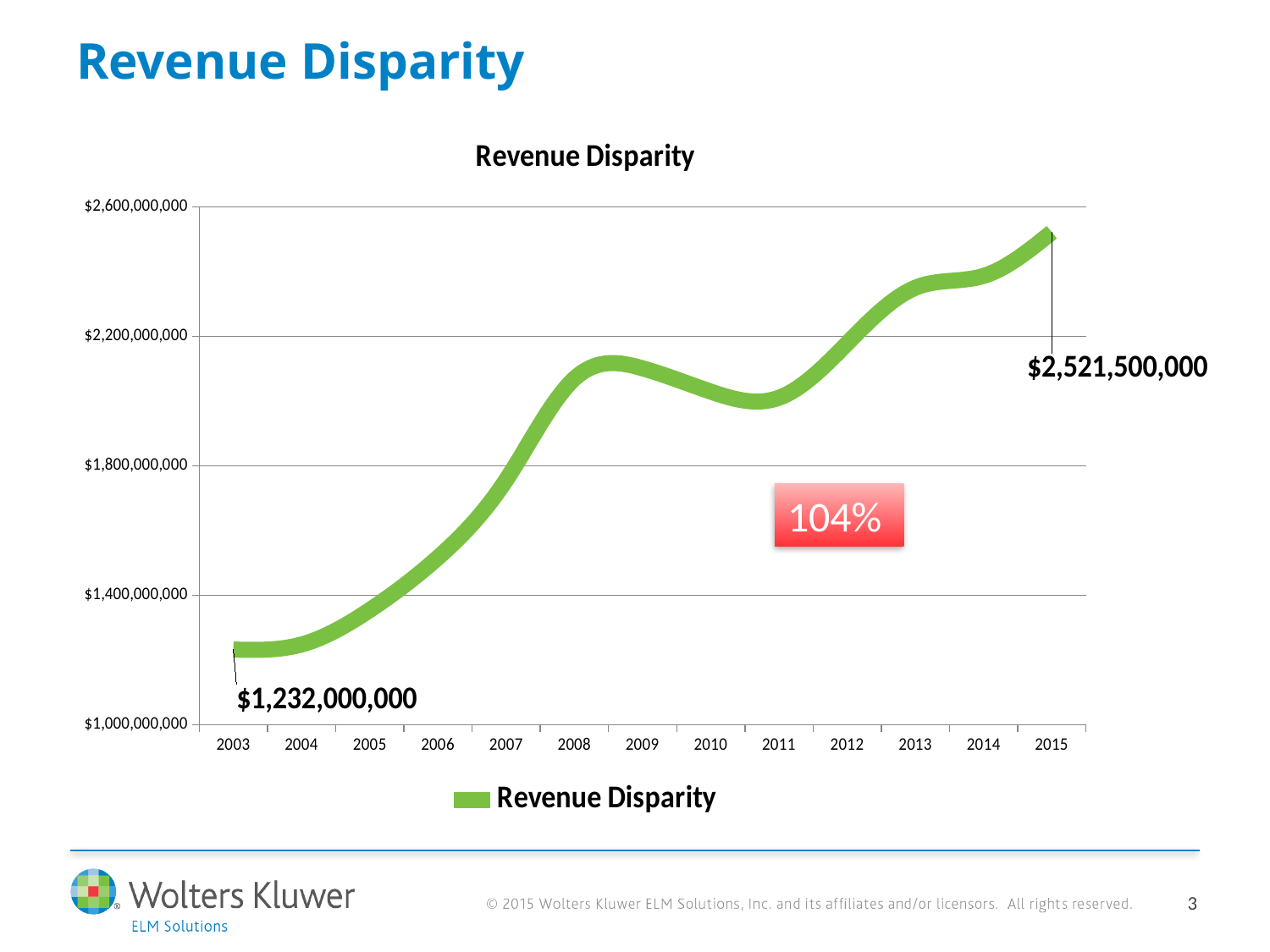
Is the value for 2008 greater or less than $1,800,000,000? greater How many years are shown on the x axis of the chart? 13 What is the value for 2015 on the Revenue Disparity chart? $2,521,500,000 What is the value for 2003 on the Revenue Disparity chart? $1,232,000,000 How many series does the legend list? 1 Do the values generally rise or fall from 2003 to 2015? rise Is the value for 2006 greater or less than $1,800,000,000? less Which year has the larger value, 2009 or 2011? 2009 What kind of chart is shown on the slide? line chart Is the value for 2013 greater or less than $2,200,000,000? greater Which year has the highest value on the chart? 2015 What is the difference between the 2015 value and the 2003 value? $1,289,500,000